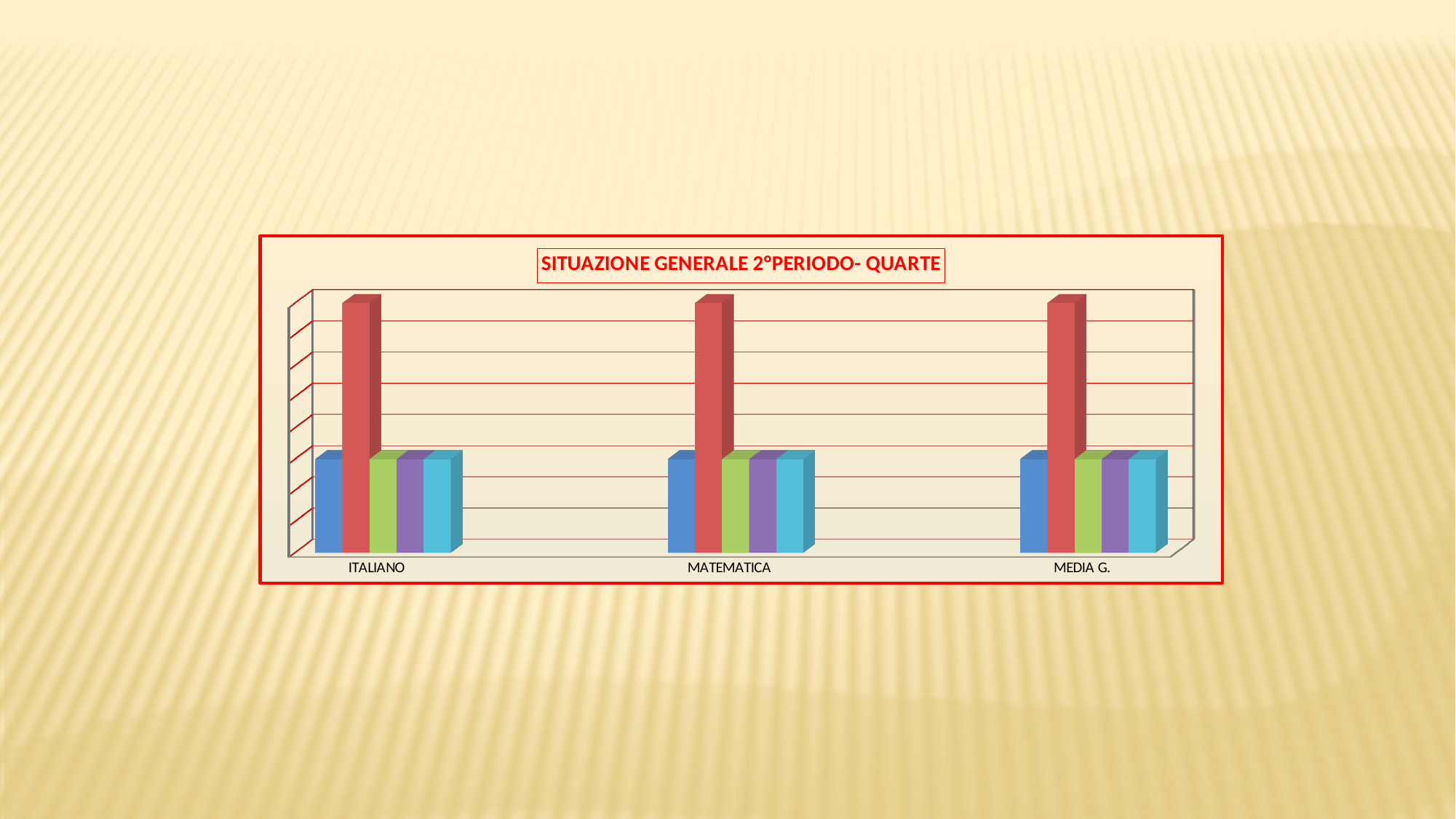
How many categories are shown on the x axis of the chart? 3 In the ITALIANO group, is the red bar or the blue bar taller? The red bar In the MEDIA G. group, is the green bar or the red bar taller? The red bar What kind of chart is shown on the slide? Bar chart Which coloured bar is the tallest in the ITALIANO group? The red bar Does the chart display a legend identifying the series? No Which coloured bar is the tallest in the MATEMATICA group? The red bar Which coloured bar is the tallest in the MEDIA G. group? The red bar How many bars are plotted for each category in the chart? 5 What are the category labels on the x axis of the chart? ITALIANO, MATEMATICA, MEDIA G. What is the title of the chart? SITUAZIONE GENERALE 2°PERIODO- QUARTE